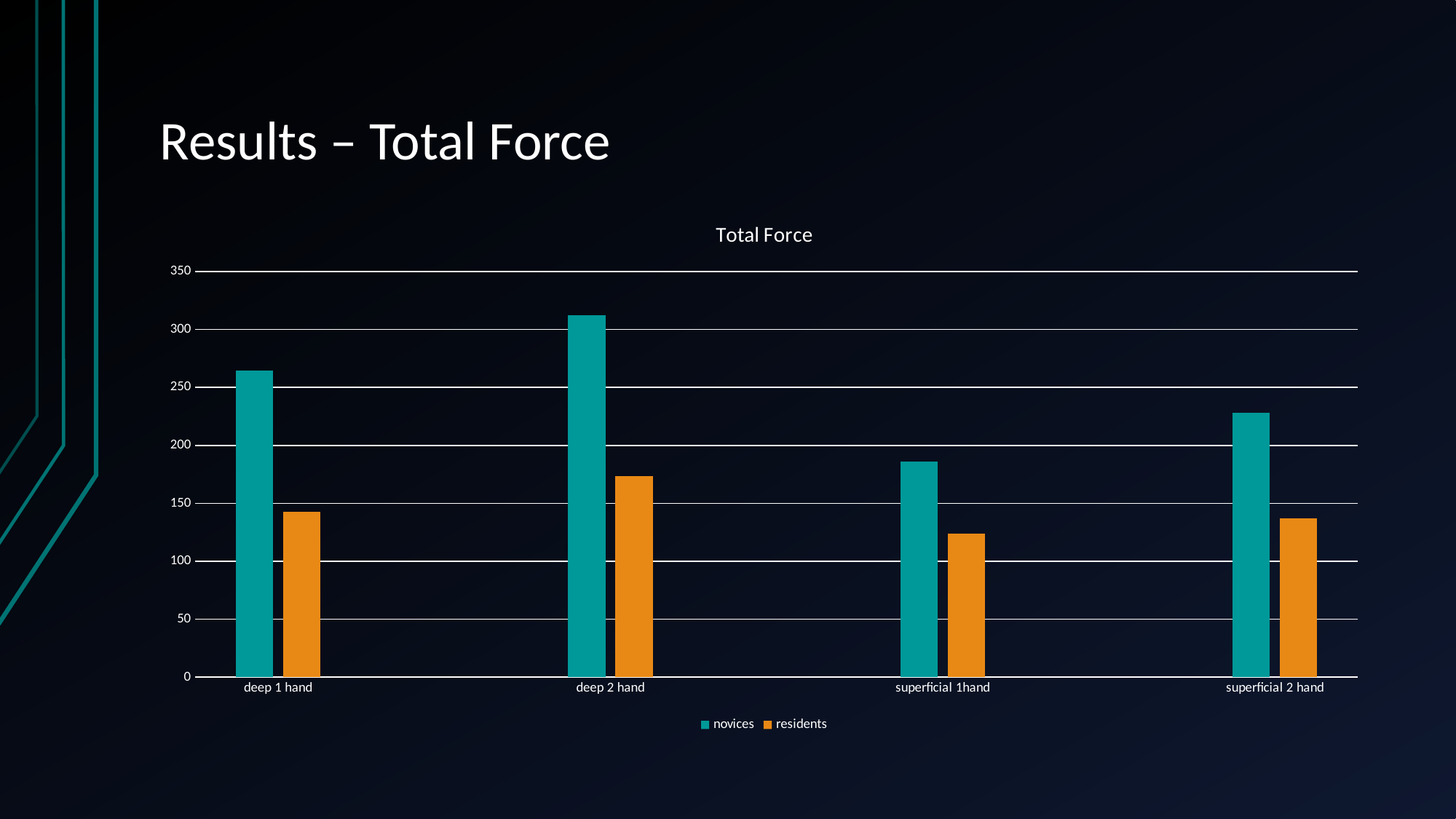
Is the novices value for superficial 1hand greater or less than 200? less Which is larger for superficial 2 hand, the novices value or the residents value? novices Which series is shown in orange in the legend? residents How many series does the legend list? 2 Is the residents value for deep 1 hand greater or less than 150? less Is the novices value for deep 2 hand greater or less than 300? greater How many categories are shown on the x axis? 4 For which category is the residents value highest? deep 2 hand What is the title of the chart? Total Force For which category is the novices value highest? deep 2 hand What type of chart is shown on the slide? bar chart For which category is the novices value lowest? superficial 1hand